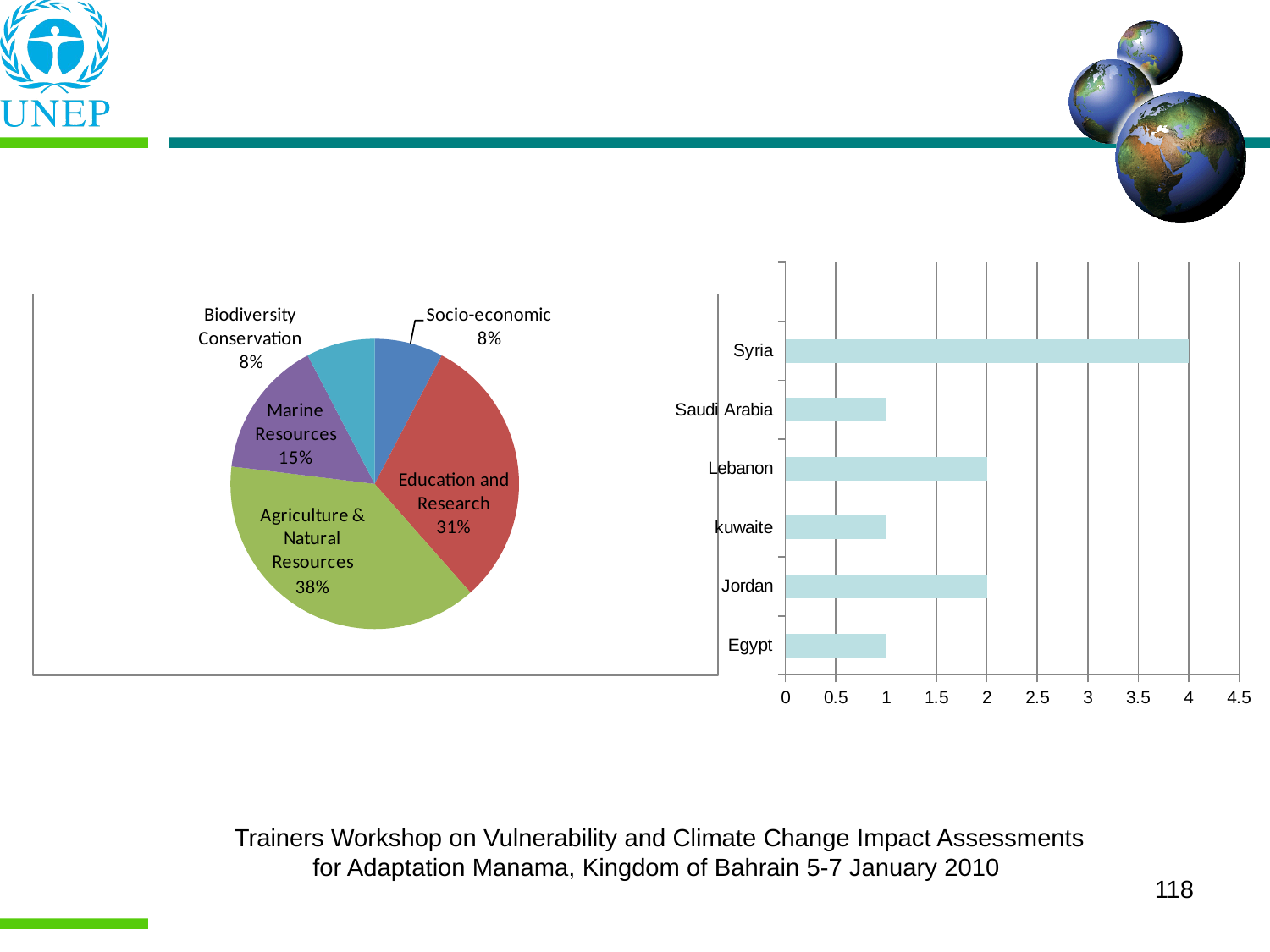
In the pie chart on the left, what is the difference between the Marine Resources share and the Biodiversity Conservation share? 7% In the bar chart on the right, what is the difference between the values for Syria and Jordan? 2 In the bar chart on the right, how many countries are shown? 6 In the pie chart on the left, which category has the largest share? Agriculture & Natural Resources What kind of chart is the chart on the right? Bar chart In the bar chart on the right, which country has the highest value? Syria In the pie chart on the left, how many slices are there? 5 In the bar chart on the right, what is the value for Syria? 4 In the pie chart on the left, what share does Agriculture & Natural Resources have? 38% In the pie chart on the left, which is larger, Education and Research or Marine Resources? Education and Research In the bar chart on the right, what is the value for Lebanon? 2 In the pie chart on the left, what share does Education and Research have? 31%